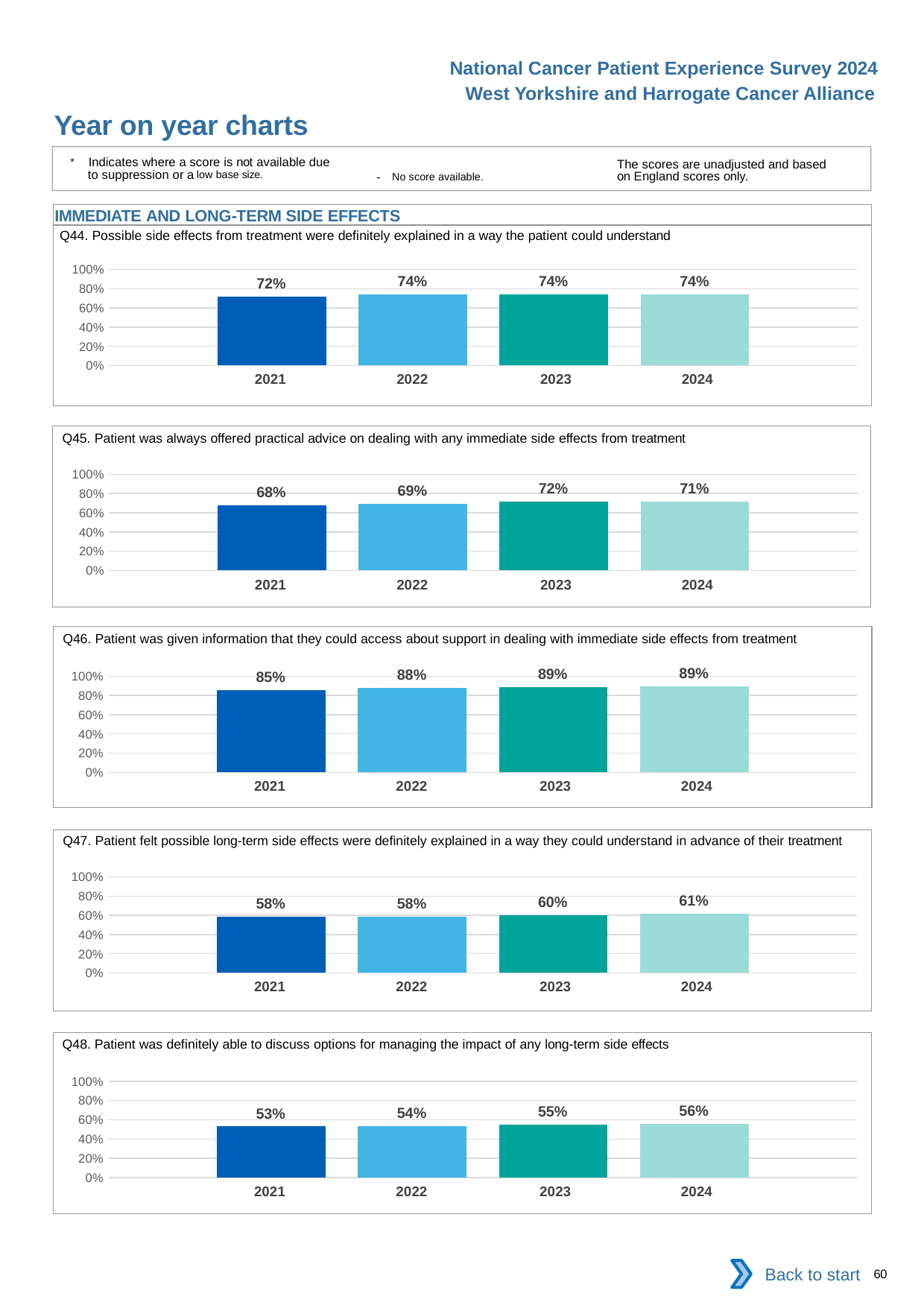
In the Q46 chart, what is the value for 2022? 88% In the Q46 chart, which year has the lowest value? 2021 In the Q48 chart, do the values rise or fall from 2021 to 2024? Rise How many years are shown in the Q44 chart? 4 In the Q45 chart, what is the difference between the 2023 and 2021 values? 4 percentage points In the Q45 chart, which year has the highest value? 2023 In the Q48 chart, what is the value for 2023? 55% In the Q44 chart, what is the value for 2021? 72% In the Q47 chart, what is the value for 2024? 61% In the Q47 chart, is the value for 2023 larger than the value for 2021? Yes In the Q48 chart, what is the difference between the 2024 and 2021 values? 3 percentage points What kind of chart is the Q45 chart? Bar chart